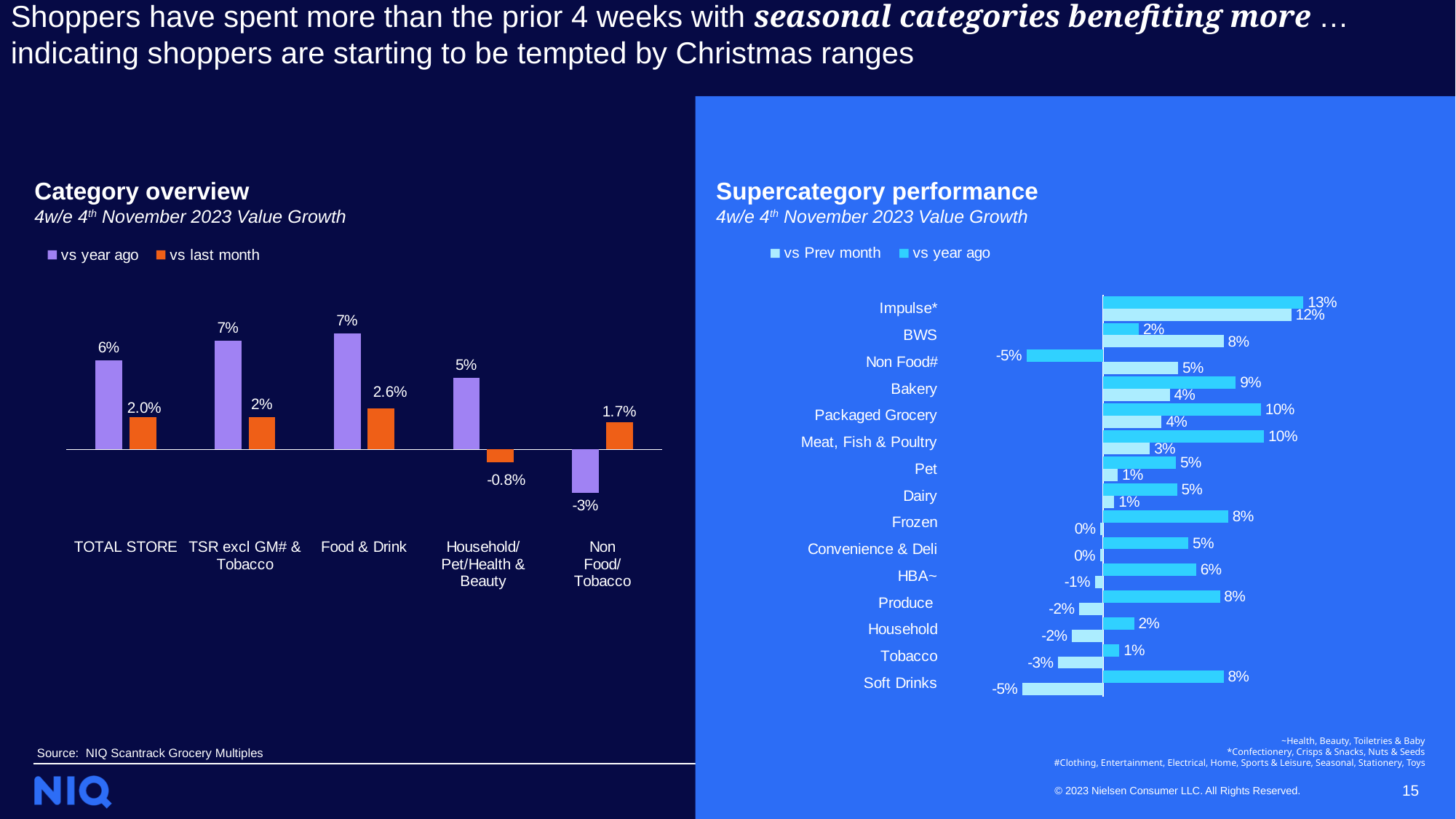
In the 'Category overview' chart, which category has the lowest 'vs year ago' value? Non Food/Tobacco In the 'Supercategory performance' chart, which has the larger 'vs year ago' value, Impulse* or BWS? Impulse* In the 'Category overview' chart, what is the 'vs last month' value for Household/Pet/Health & Beauty? -0.8% In the 'Supercategory performance' chart, what is the 'vs Prev month' value for Impulse*? 12% What are the two legend entries of the 'Supercategory performance' chart? vs Prev month and vs year ago How many supercategories are listed in the 'Supercategory performance' chart? 15 What kind of chart is the 'Category overview' chart on the left? Bar chart In the 'Category overview' chart, what is the difference between the 'vs year ago' and 'vs last month' values for TOTAL STORE? 4 percentage points How many categories are shown in the 'Category overview' chart? 5 How many series does the legend of the 'Category overview' chart list? 2 In the 'Supercategory performance' chart, which supercategory has the highest 'vs year ago' value? Impulse* In the 'Category overview' chart, what is the 'vs year ago' value for Food & Drink? 7%